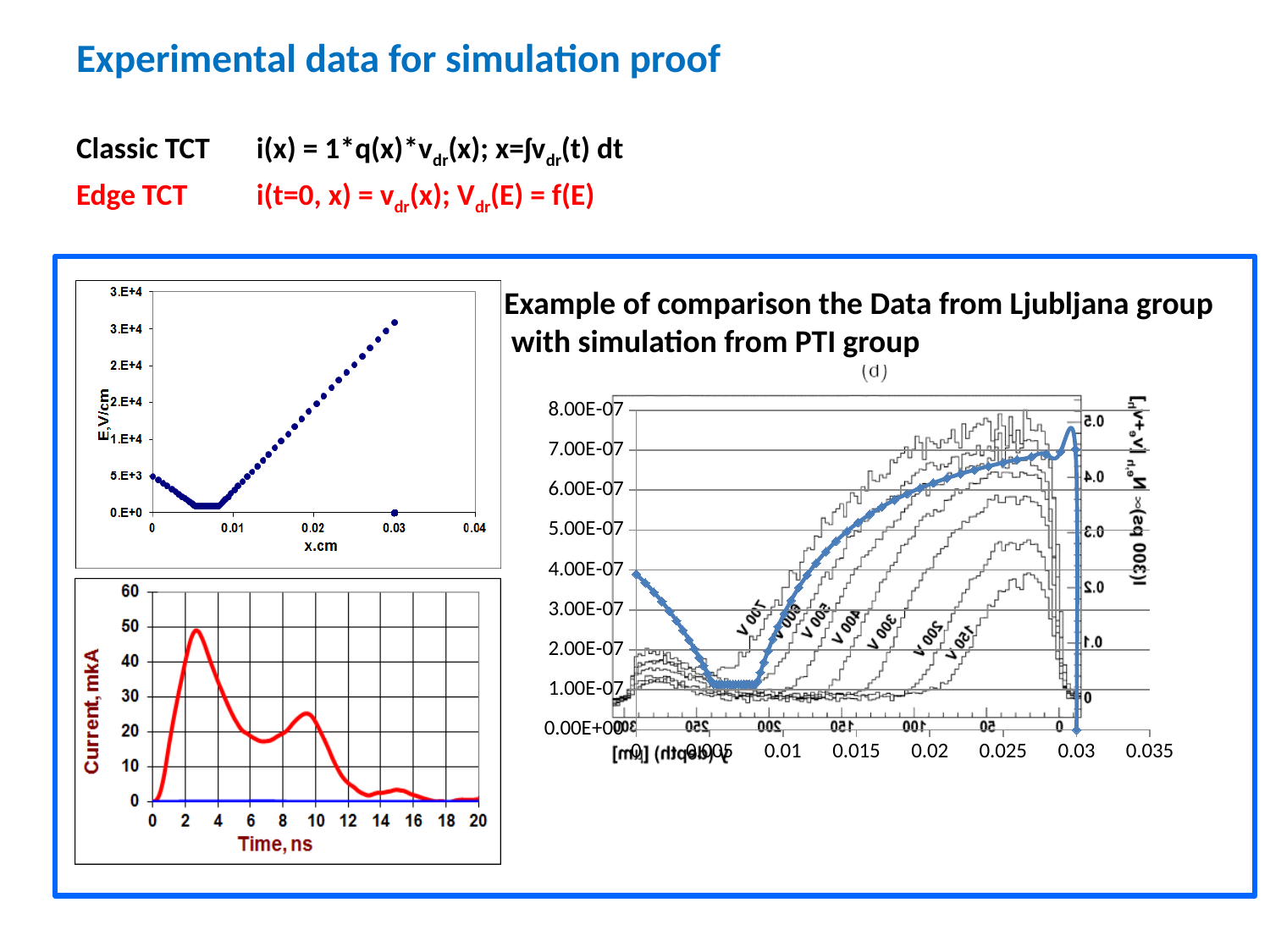
What kind of chart is the bottom-left chart (Current, mkA versus Time, ns)? line chart In the top-left chart, what is the highest tick value shown on the x axis? 0.04 In the bottom-left chart, is the peak current greater or less than 40? greater In the bottom-left chart, what is the highest tick value shown on the Time axis? 20 In the top-left chart, do the values rise or fall along the x axis between x = 0.01 and x = 0.03? rise In the top-left chart, what is the label of the x axis? x,cm In the bottom-left chart, what is the label of the y axis? Current, mkA In the top-left chart, is the value of E at x = 0 greater or less than 1.E+4? less In the bottom-left chart, is the current at 14 ns greater or less than 10? less What kind of chart is the top-left chart (E, V/cm versus x, cm)? scatter chart In the right-hand chart, what is the highest tick value shown on the left y axis? 8.00E-07